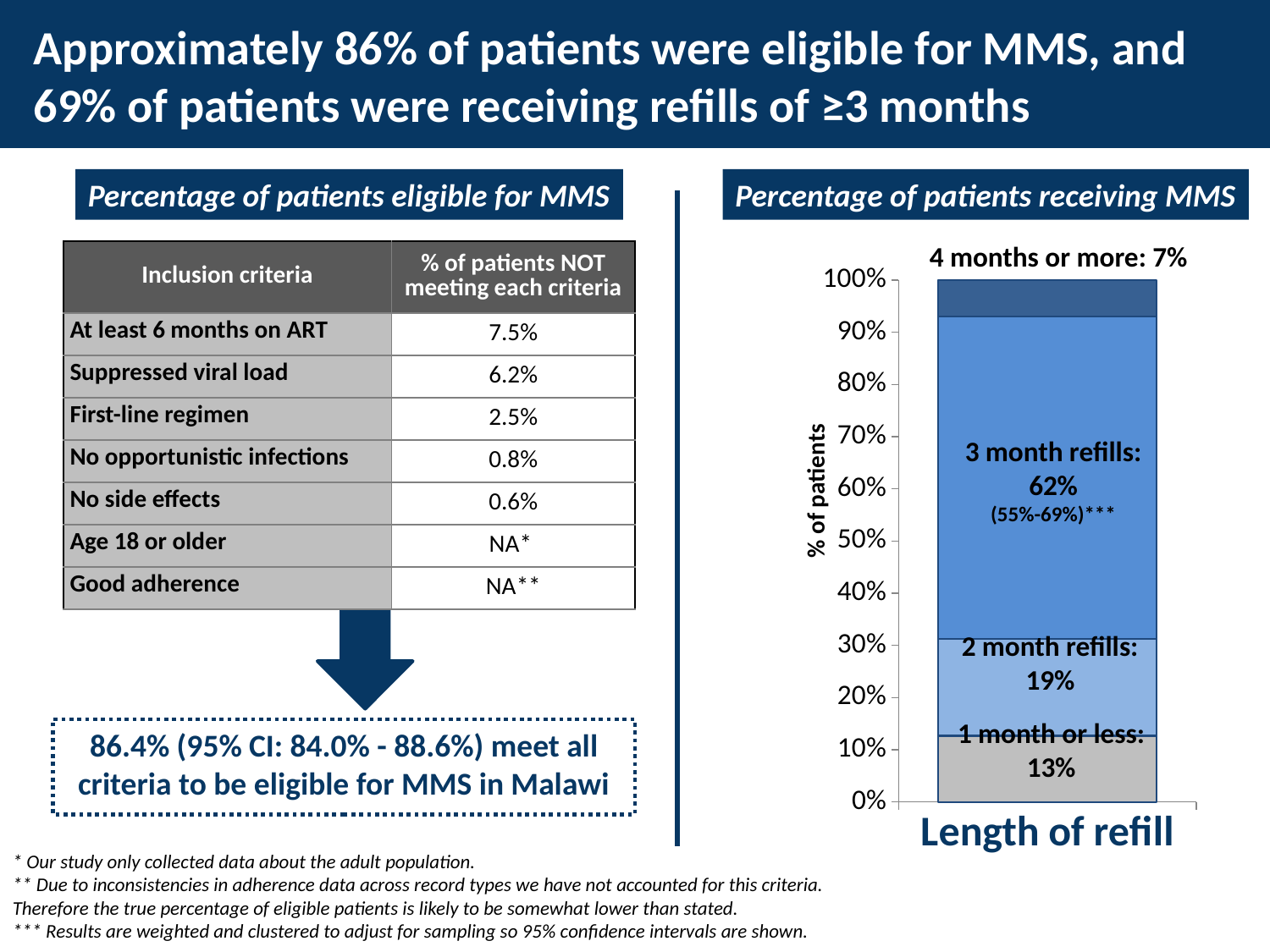
In the chart 'Percentage of patients receiving MMS', what is the difference between the share for 2 month refills and the share for 1 month or less? 6% In the chart 'Percentage of patients receiving MMS', how many percentage points higher is the share for 3 month refills than for 2 month refills? 43% In the chart 'Percentage of patients receiving MMS', which is larger: the share for 1 month or less or the share for 4 months or more? 1 month or less In the chart 'Percentage of patients receiving MMS', which refill length accounts for the largest share of patients? 3 month refills In the chart 'Percentage of patients receiving MMS', what percentage of patients received refills of 4 months or more? 7% In the chart 'Percentage of patients receiving MMS', what percentage of patients received refills of 1 month or less? 13% In the chart 'Percentage of patients receiving MMS', what is the 95% confidence interval shown for 3 month refills? 55%-69% In the chart 'Percentage of patients receiving MMS', which refill length accounts for the smallest share of patients? 4 months or more In the chart 'Percentage of patients receiving MMS', what percentage of patients received 2 month refills? 19% How many refill-length segments make up the stacked bar in the chart 'Percentage of patients receiving MMS'? 4 In the chart 'Percentage of patients receiving MMS', what percentage of patients received 3 month refills? 62% What type of chart is 'Percentage of patients receiving MMS'? Stacked bar chart